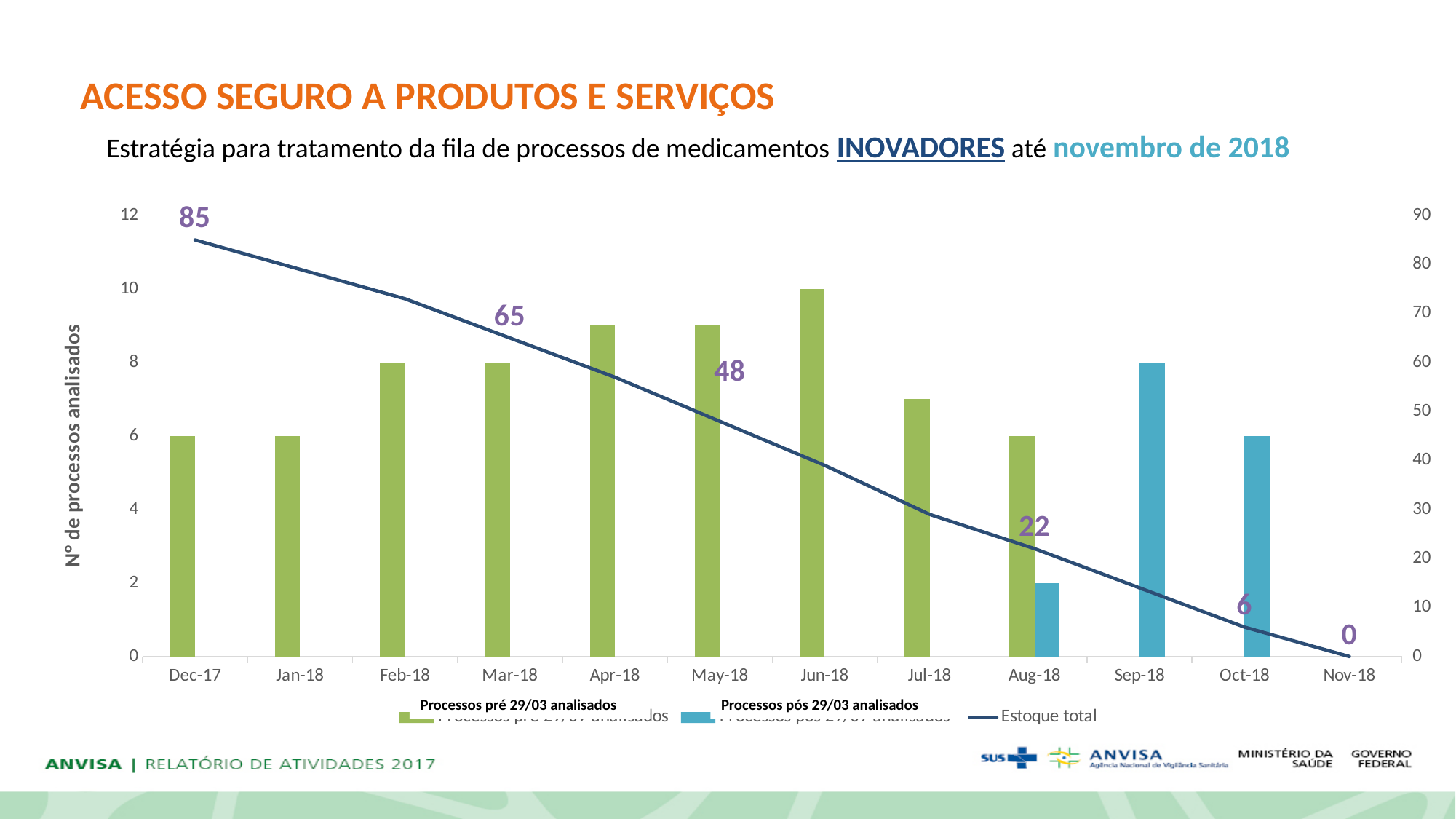
By how much does Estoque total fall between Dec-17 (85) and Mar-18 (65)? 20 How many months are shown on the x axis? 12 What is the value of Estoque total for Nov-18? 0 What kind of chart is shown on the slide? combined bar and line chart What is the value of the Processos pós 29/03 analisados bar for Aug-18? 2 In which month is the Processos pré 29/03 analisados bar highest? Jun-18 What is the value of Estoque total for Aug-18? 22 What is the difference between the Estoque total values for May-18 and Aug-18? 26 What is the value of Estoque total for Dec-17? 85 Is the Processos pré 29/03 analisados value for Apr-18 greater or less than 8? greater How many series does the legend list? 3 Does the Estoque total line rise or fall from Dec-17 to Nov-18? falls